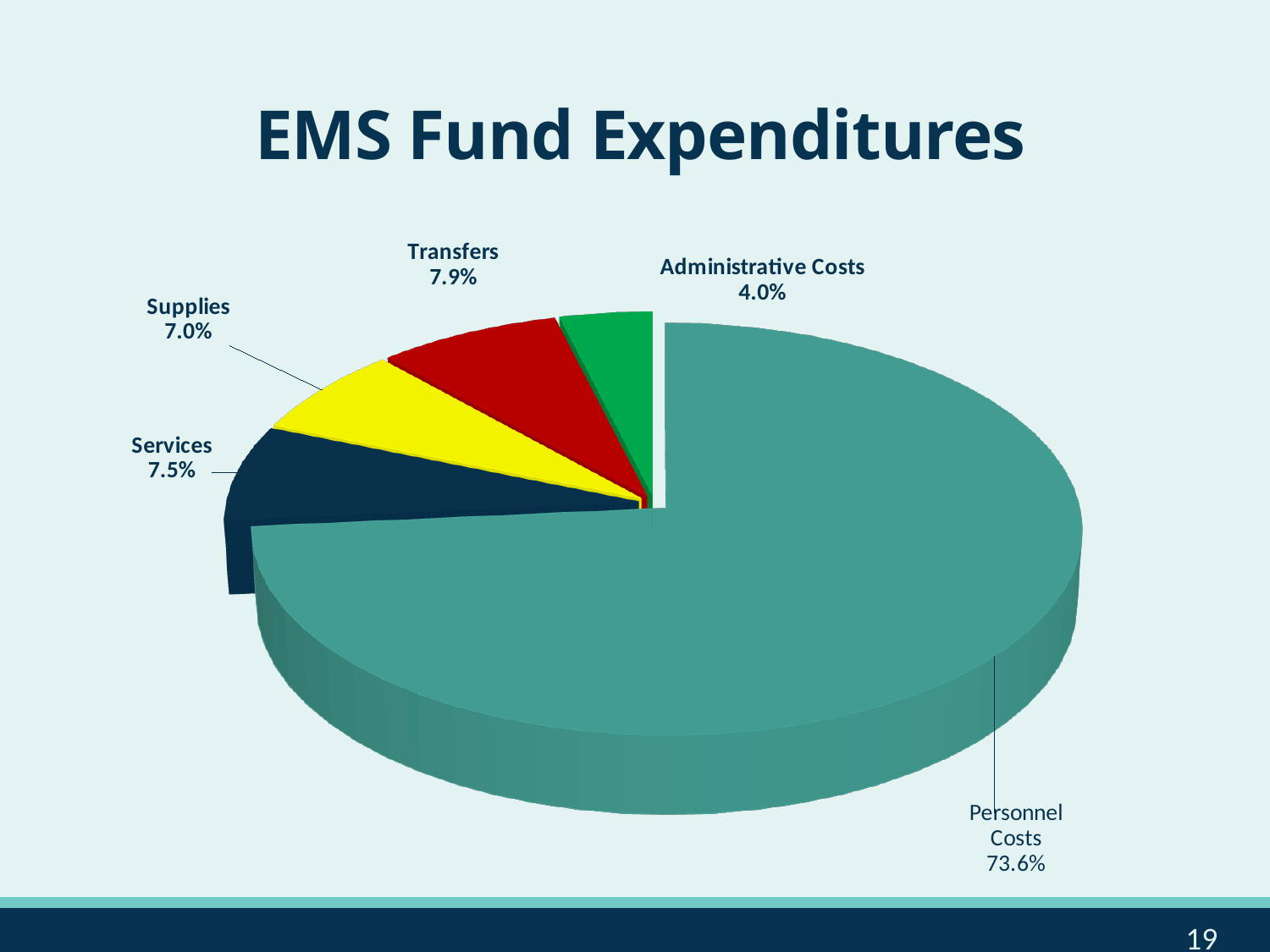
How many categories are shown in the pie chart? 5 What is the title of the chart? EMS Fund Expenditures What type of chart is shown on the slide? Pie chart What is the difference in percentage points between Transfers and Supplies? 0.9 What is the value shown for Administrative Costs? 4.0% What is the value shown for Services? 7.5% What share of EMS Fund Expenditures is Personnel Costs? 73.6% Which category has the largest share of the pie? Personnel Costs Which category has the smallest share of the pie? Administrative Costs What is the value shown for Supplies? 7.0% Which is larger, Services or Administrative Costs? Services What percentage of the pie is Transfers? 7.9%